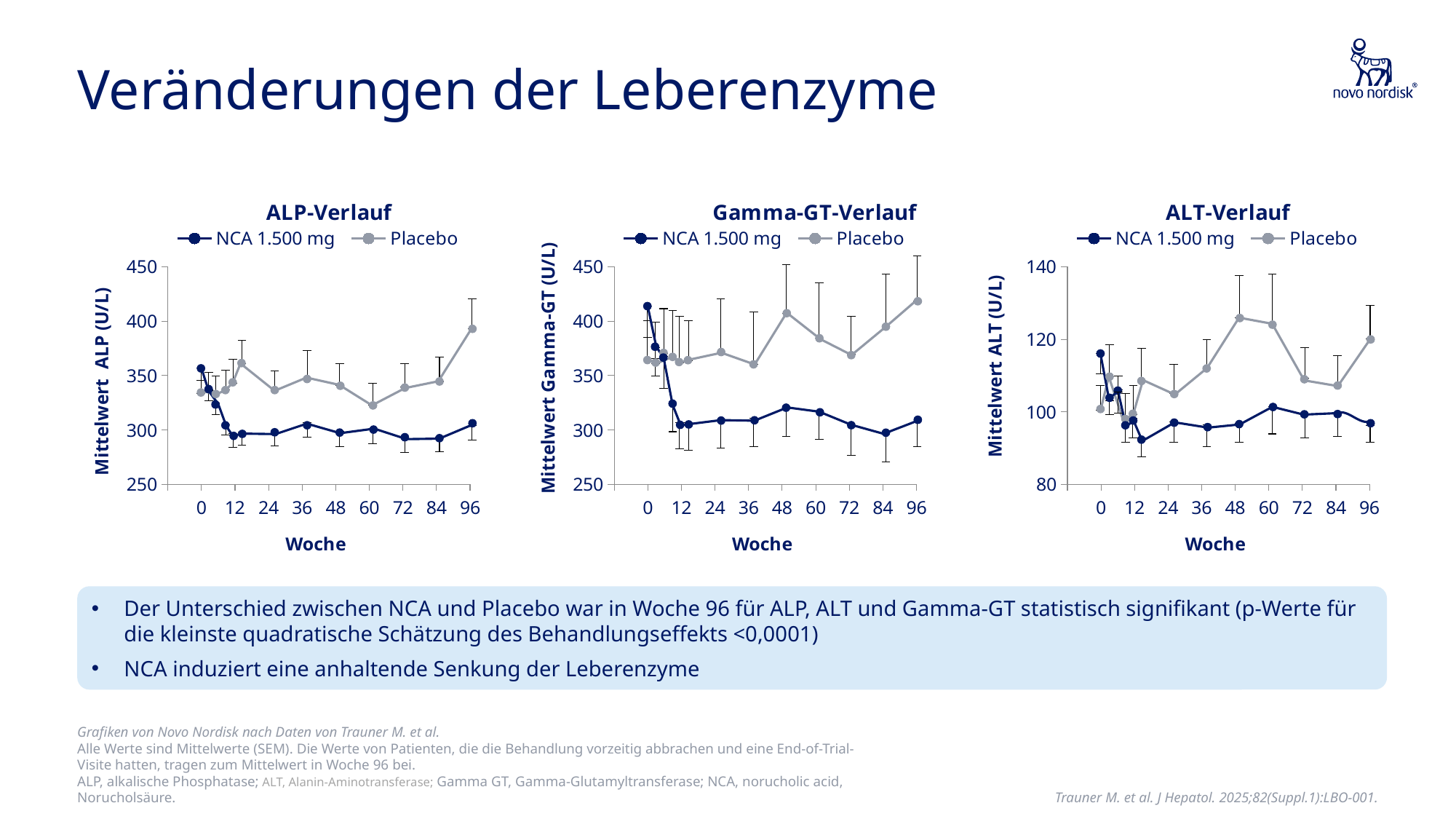
What is the x-axis label of the ALT-Verlauf chart? Woche In the ALT-Verlauf chart, which series has the higher value at week 96, NCA 1.500 mg or Placebo? Placebo How many charts are shown on the slide? 3 In the ALP-Verlauf chart, which series has the higher value at week 96, NCA 1.500 mg or Placebo? Placebo In the ALP-Verlauf chart, is the Placebo value at week 96 greater or less than 350? greater How many series does the legend of the Gamma-GT-Verlauf chart list? 2 What kind of chart is the ALP-Verlauf chart? line chart In the Gamma-GT-Verlauf chart, does the NCA 1.500 mg series rise or fall between week 0 and week 12? fall In the ALT-Verlauf chart, is the Placebo value at week 48 greater or less than 120? greater In the Gamma-GT-Verlauf chart, is the NCA 1.500 mg value at week 96 greater or less than 350? less